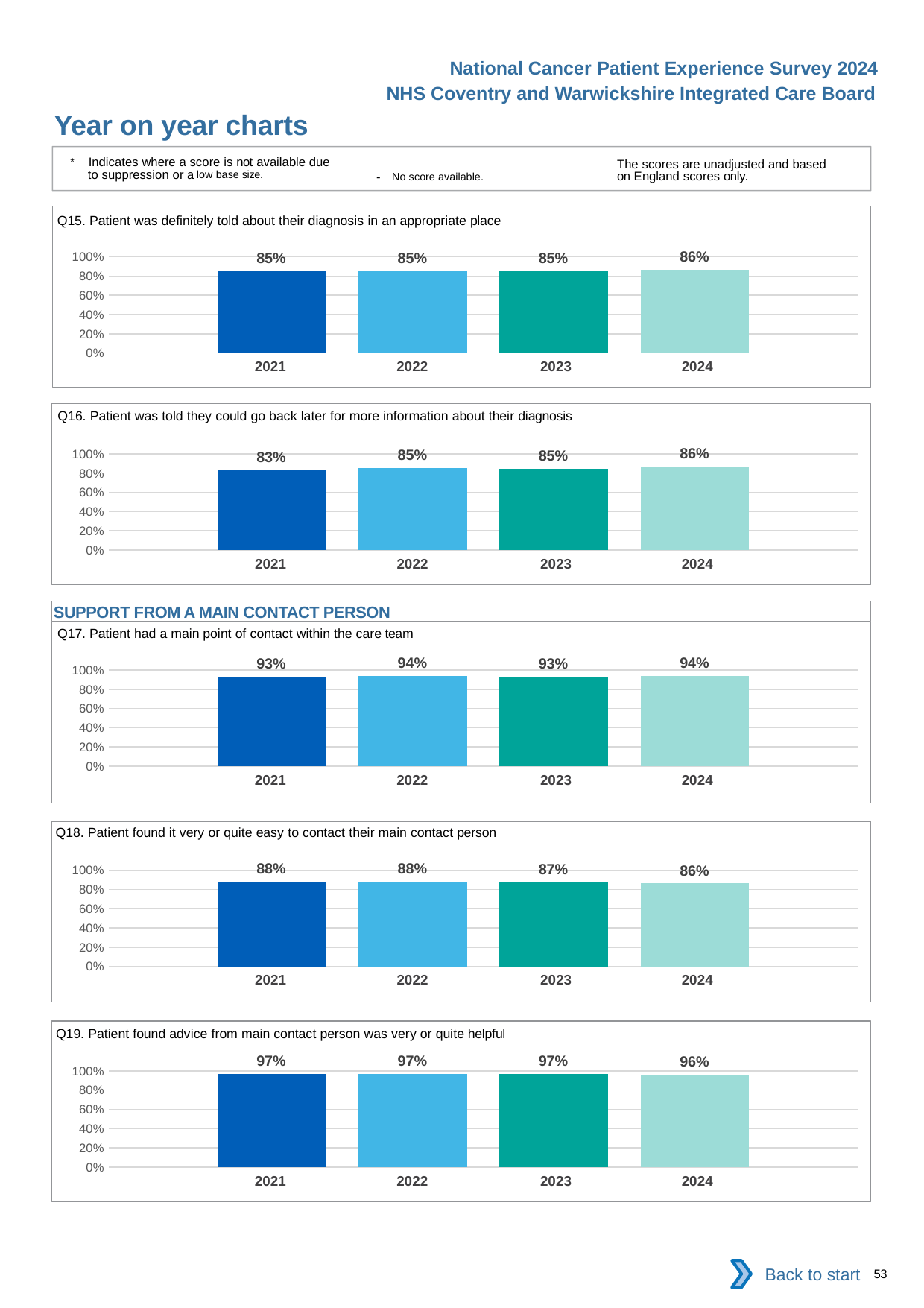
In the Q16 chart, which year has the highest value? 2024 In the Q19 chart, which is larger, the value for 2023 or the value for 2024? 2023 What kind of chart is the Q15 chart? bar chart In the Q18 chart, which year has the lowest value? 2024 In the Q16 chart, what is the difference between the 2024 and 2021 values? 3% In the Q16 chart, what is the value for 2021? 83% In the Q18 chart, what is the difference between the 2021 and 2024 values? 2% In the Q17 chart, what is the value for 2022? 94% In the Q18 chart, do the values rise or fall from 2021 to 2024? fall How many years are shown in the Q19 chart? 4 In the Q16 chart, which year has the lowest value? 2021 In the Q15 chart, what is the value for 2024? 86%